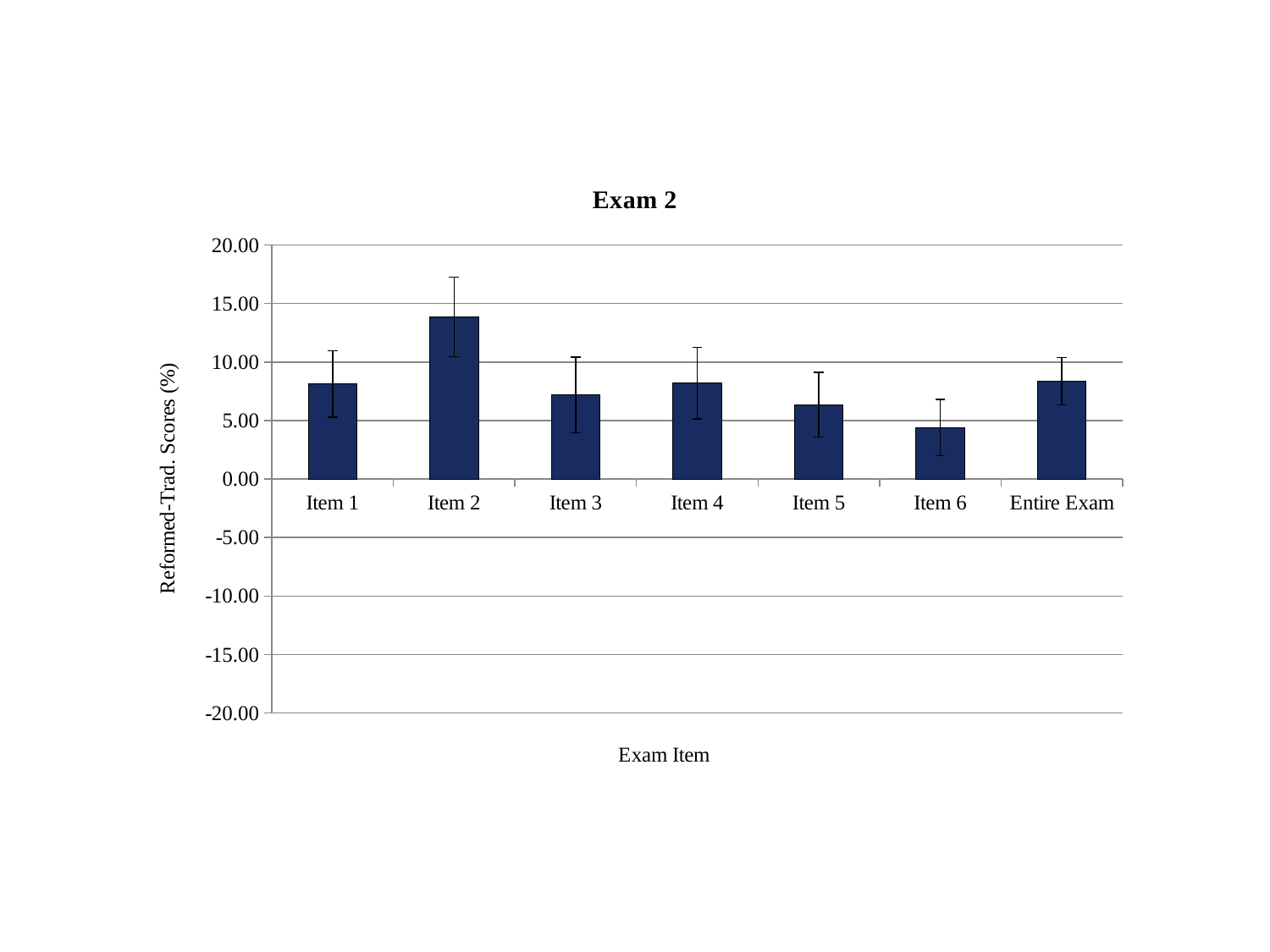
Which is larger, the value for Item 6 or the value for Item 3? Item 3 What is the label of the y axis? Reformed-Trad. Scores (%) Is the value for Item 6 greater or less than 5.00? less What is the title of the chart? Exam 2 Is the value for Item 1 greater or less than 5.00? greater Is the value for Item 2 greater or less than 10.00? greater How many categories are plotted on the x axis? 7 Which category has the lowest value? Item 6 Which category has the highest value? Item 2 What kind of chart is shown on the slide? bar chart Which is larger, the value for Item 2 or the value for Item 5? Item 2